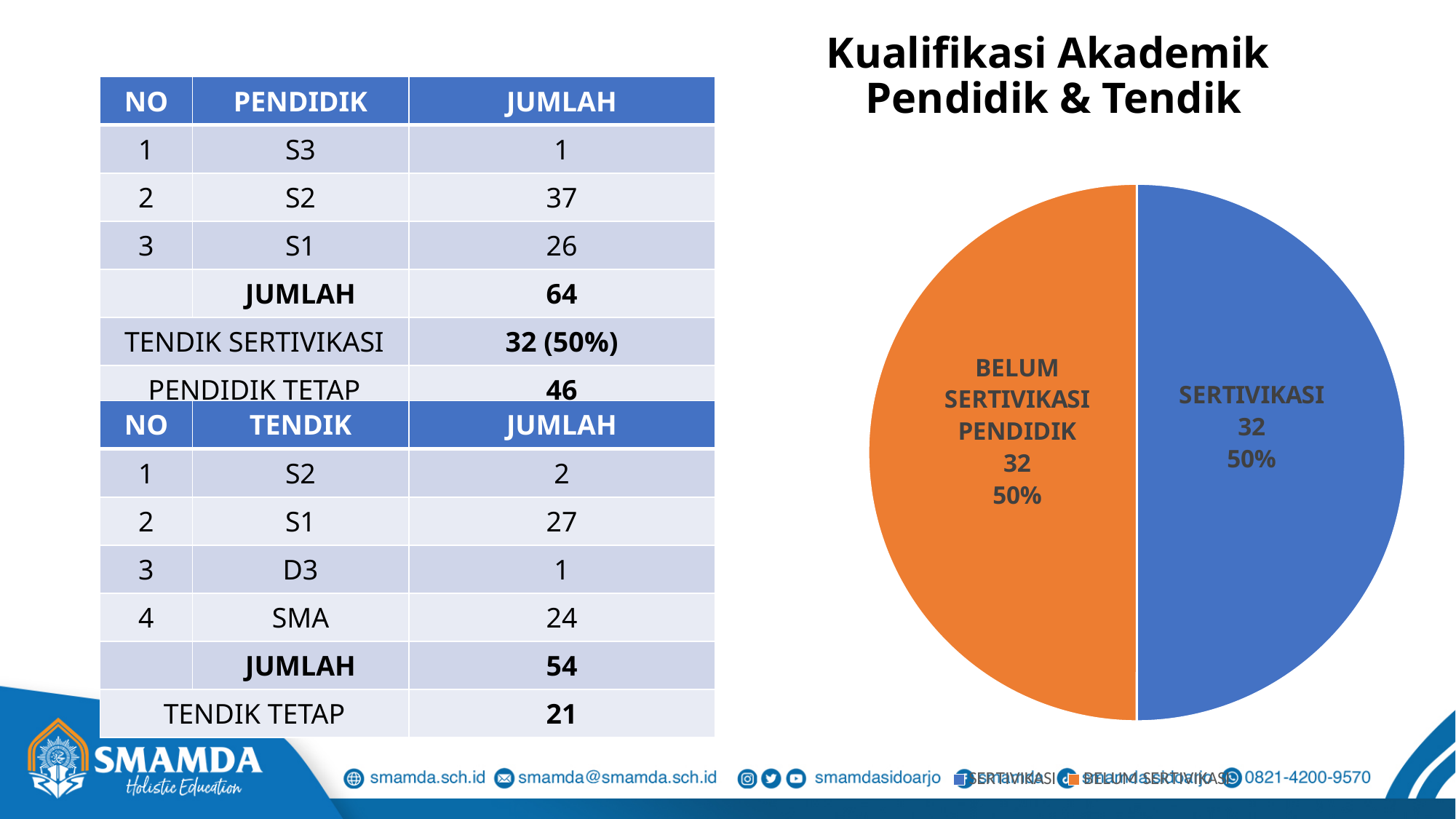
What is the total of the two slice values in the pie chart? 64 How many slices does the pie chart have? 2 What share of the pie does the SERTIVIKASI slice represent? 50% What is the value shown for the SERTIVIKASI slice of the pie chart? 32 What is the difference between the SERTIVIKASI and BELUM SERTIVIKASI PENDIDIK slice values in the pie chart? 0 What is the value shown for the BELUM SERTIVIKASI PENDIDIK slice of the pie chart? 32 What colour is the SERTIVIKASI slice of the pie chart? blue What colour is the BELUM SERTIVIKASI PENDIDIK slice of the pie chart? orange What type of chart is shown on the slide? pie chart What share of the pie does the BELUM SERTIVIKASI PENDIDIK slice represent? 50%